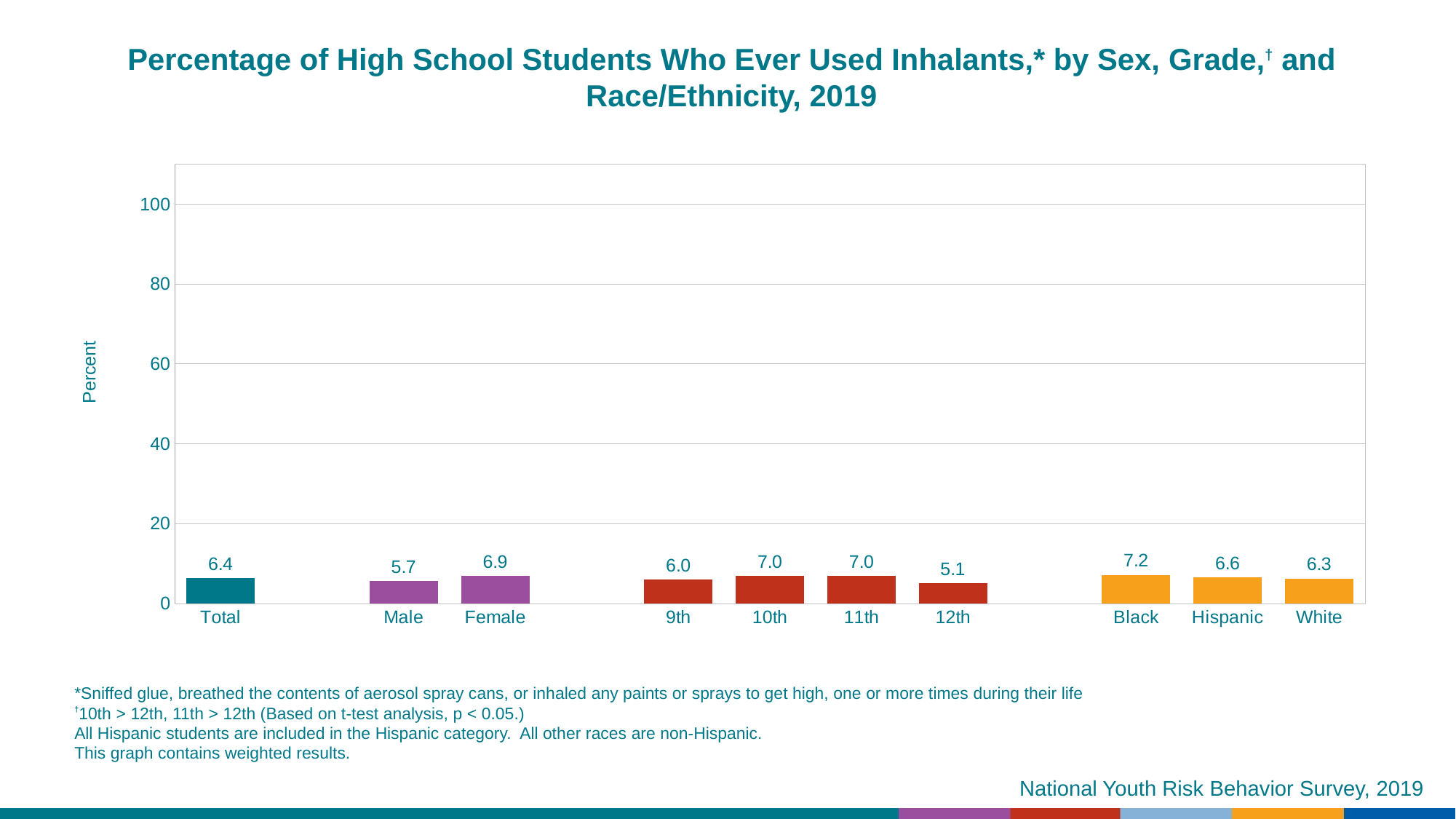
What is the value for Hispanic? 6.6 What is the difference between the values for Female and Male? 1.2 How many categories are shown on the x axis? 10 What is the value for Female? 6.9 Is the value for 10th grade greater or less than 20? less What kind of chart is this? bar chart Which is larger, the value for Black or the value for White? Black What is the value for Total? 6.4 Which category has the lowest value? 12th What is the value for 12th grade? 5.1 Which category has the highest value? Black What is the label of the y axis? Percent